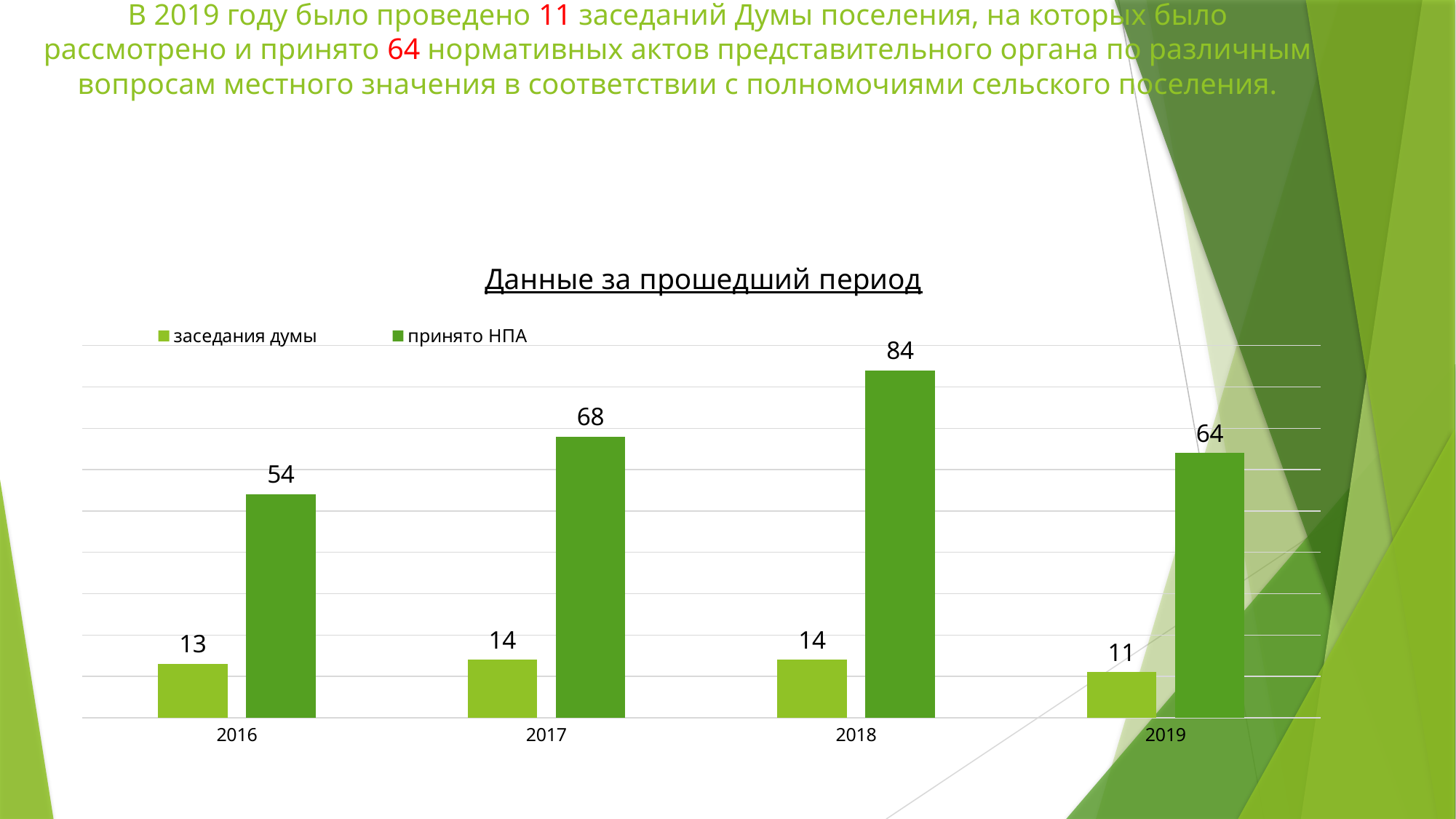
How many series does the legend list? 2 What is the value for "принято НПА" in 2018? 84 What is the difference between the "принято НПА" values for 2018 and 2019? 20 Does the value for "принято НПА" rise or fall from 2018 to 2019? fall How many years are shown on the x axis? 4 What is the value for "принято НПА" in 2019? 64 Which is larger: "принято НПА" in 2017 or in 2016? 2017 What kind of chart is shown on the slide? bar chart Which year has the highest value for "принято НПА"? 2018 What is the title of the chart? Данные за прошедший период Which year has the lowest value for "заседания думы"? 2019 What is the value for "заседания думы" in 2016? 13